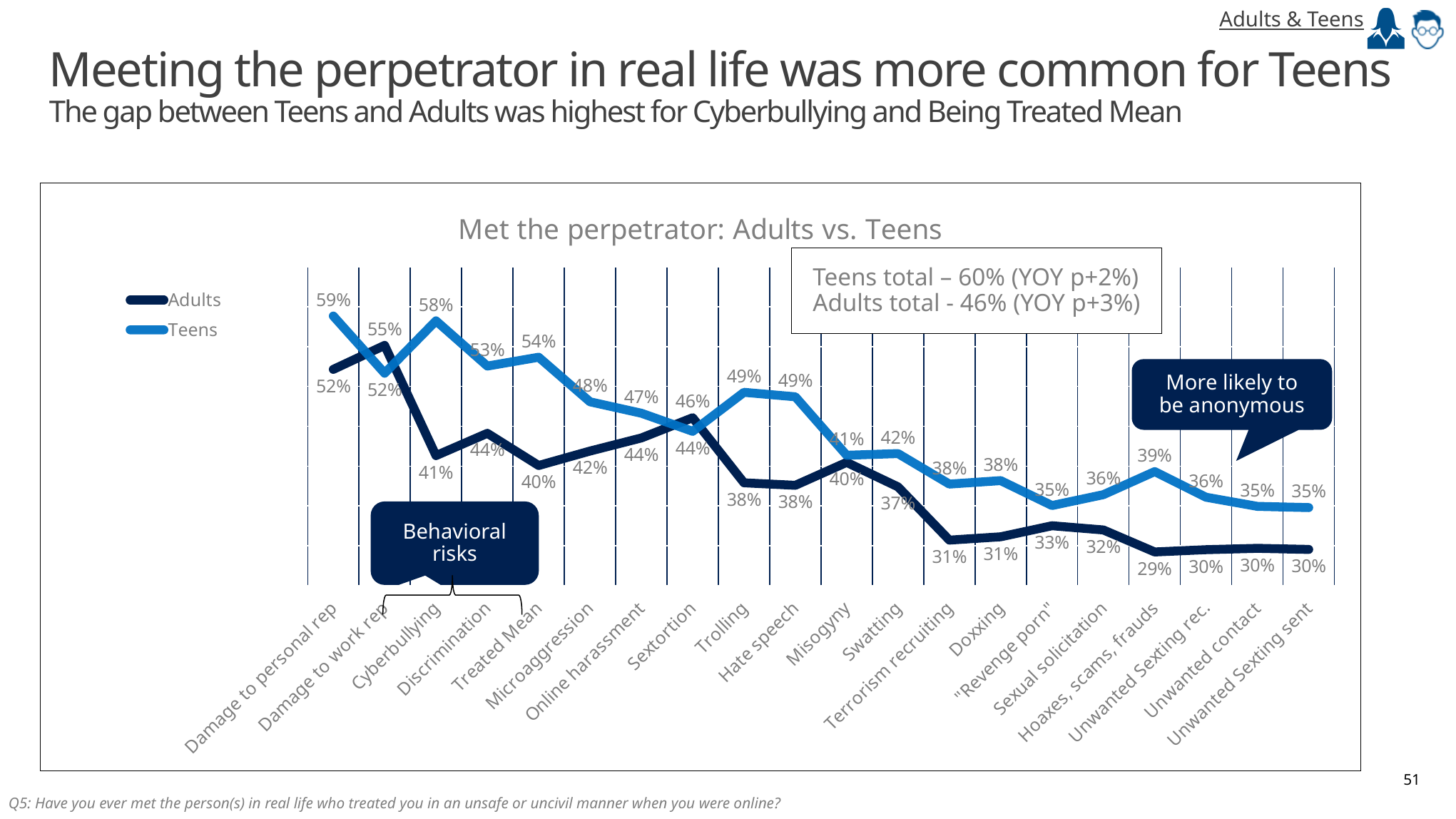
According to the text box on the chart, what is the Teens total? 60% What is the Adults value for Cyberbullying? 41% Which category has the highest Teens value? Damage to personal rep What is the difference between the Teens and Adults values for Treated Mean? 14 percentage points How many categories are shown on the x axis? 20 What is the Teens value for Cyberbullying? 58% What kind of chart is shown? Line chart What is the difference between the Teens and Adults values for Cyberbullying? 17 percentage points How many series does the legend list? 2 Which category has the lowest Adults value? Hoaxes, scams, frauds For Damage to work rep, which series has the higher value, Adults or Teens? Adults What is the Teens value for Hoaxes, scams, frauds? 39%